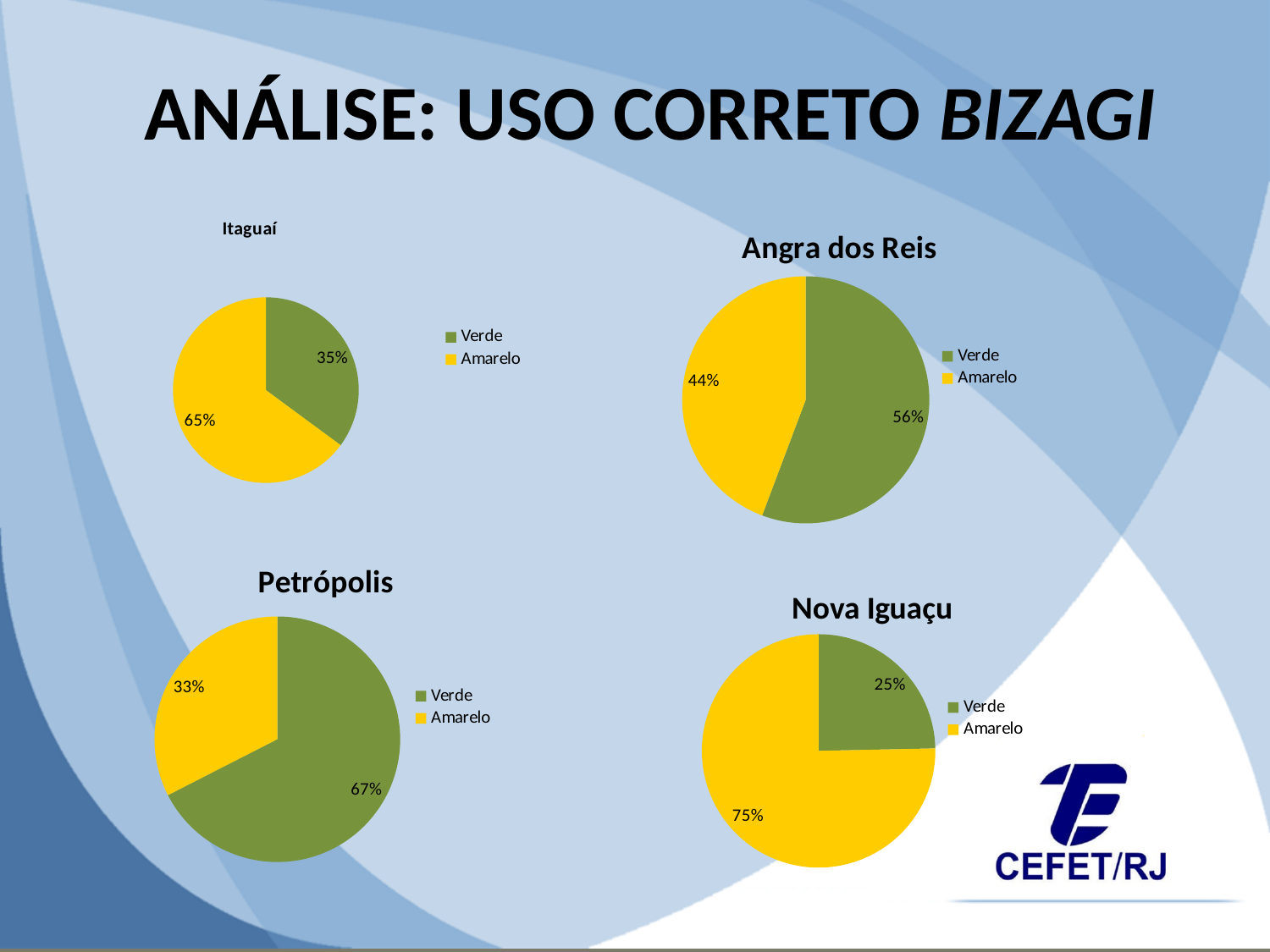
In the Angra dos Reis chart, what share does Amarelo have? 44% In the Petrópolis chart, which slice is the largest? Verde In the Nova Iguaçu chart, what share does Verde have? 25% In the Angra dos Reis chart, which is larger, Verde or Amarelo? Verde In the Itaguaí chart, what share does Amarelo have? 65% In the Nova Iguaçu chart, which slice is the smallest? Verde In the Nova Iguaçu chart, what is the difference between the Amarelo and Verde shares? 50% In the Angra dos Reis chart, what share does Verde have? 56% In the Itaguaí chart, what share does Verde have? 35% What kind of chart is the Itaguaí chart? Pie chart In the Petrópolis chart, what share does Amarelo have? 33% How many entries does the legend of the Petrópolis chart list? 2